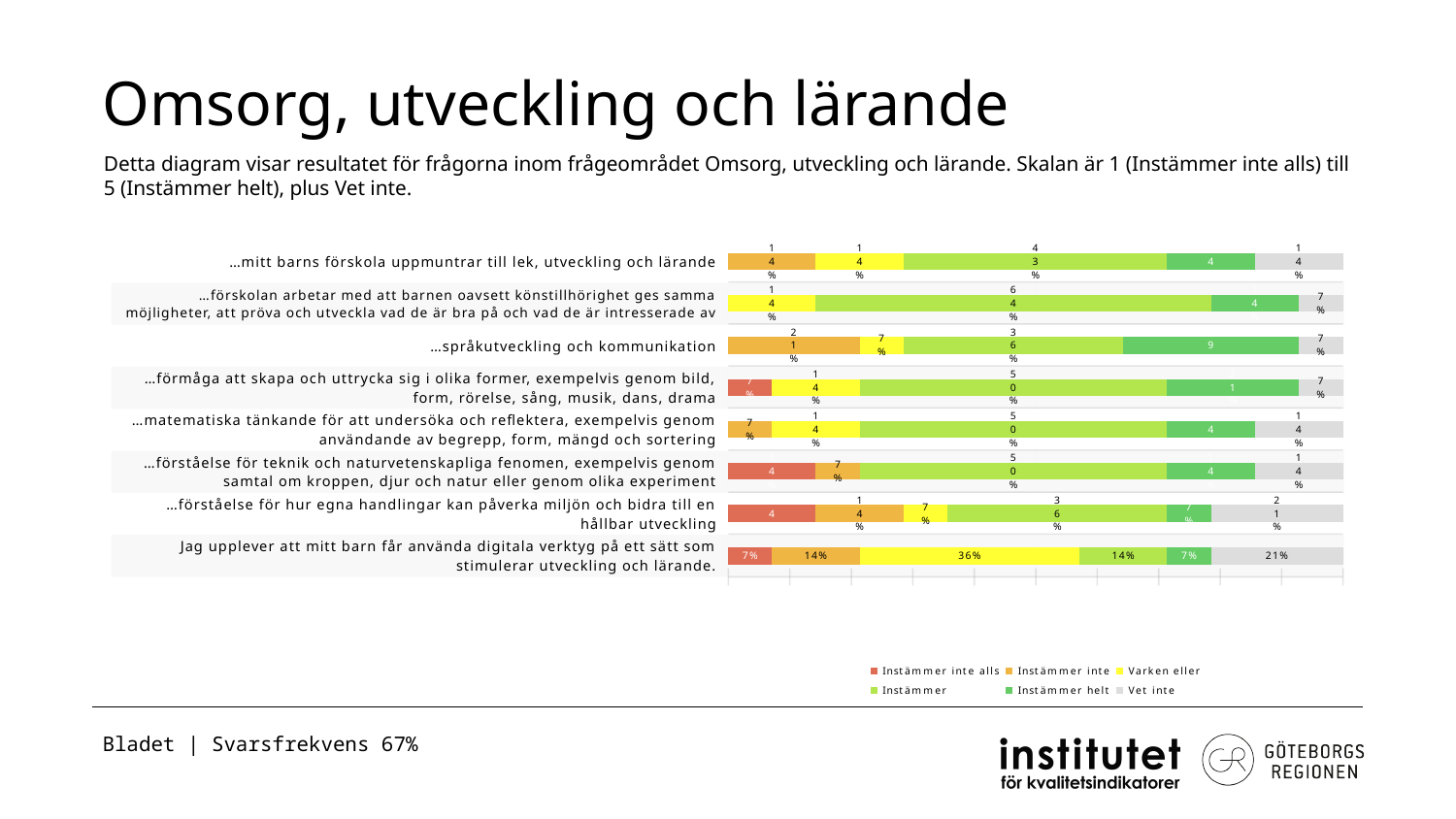
How many question statements (categories) are plotted in the chart? 8 For the statement 'Jag upplever att mitt barn får använda digitala verktyg på ett sätt som stimulerar utveckling och lärande.', which response category has the largest share? Varken eller For the statement 'Jag upplever att mitt barn får använda digitala verktyg på ett sätt som stimulerar utveckling och lärande.', which is larger: the 'Instämmer' share or the 'Vet inte' share? Vet inte For the statement 'Jag upplever att mitt barn får använda digitala verktyg på ett sätt som stimulerar utveckling och lärande.', what is the share for 'Instämmer inte'? 14% What kind of chart is shown on the slide? Stacked bar chart For the statement 'Jag upplever att mitt barn får använda digitala verktyg på ett sätt som stimulerar utveckling och lärande.', what is the share for 'Instämmer'? 14% How many series does the chart legend list? 6 For the statement 'Jag upplever att mitt barn får använda digitala verktyg på ett sätt som stimulerar utveckling och lärande.', what is the share for 'Vet inte'? 21% Which colour represents 'Instämmer inte alls' in the chart legend? Red What is the last entry listed in the chart legend? Vet inte For the statement 'Jag upplever att mitt barn får använda digitala verktyg på ett sätt som stimulerar utveckling och lärande.', what is the share for 'Instämmer inte alls'? 7% For the statement 'Jag upplever att mitt barn får använda digitala verktyg på ett sätt som stimulerar utveckling och lärande.', what is the difference between the 'Vet inte' share and the 'Instämmer helt' share? 14 percentage points